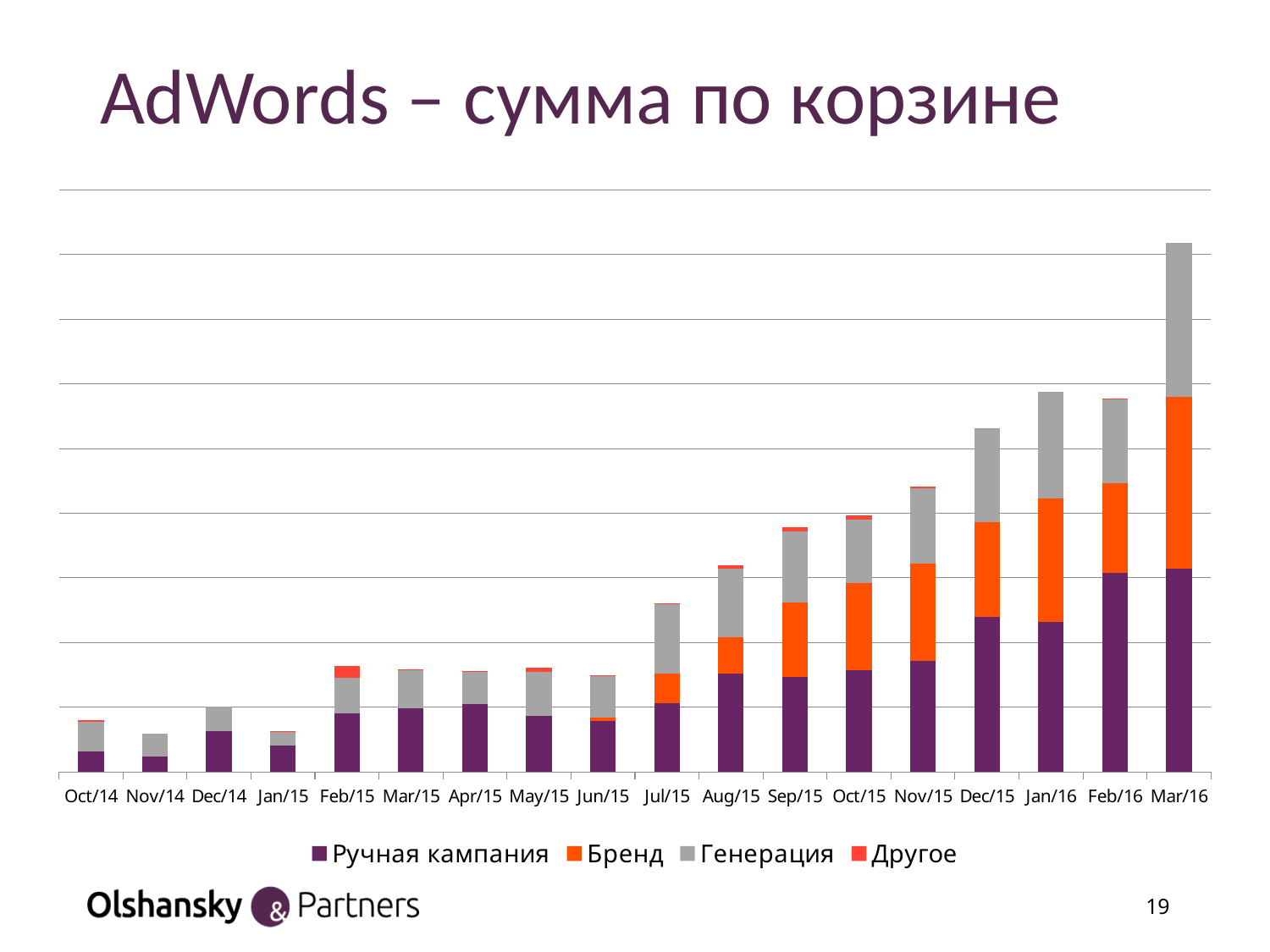
Which month has the larger total bar, Feb/16 or Mar/16? Mar/16 Do the total bar heights generally rise or fall from Oct/14 to Mar/16? Rise Which month has the larger total bar, Nov/14 or Dec/14? Dec/14 How many series does the legend of the chart list? 4 What is the title of the chart on the slide? AdWords – сумма по корзине Which month has the lowest total bar in the chart? Nov/14 Which series is shown in orange in the chart's legend? Бренд Which month has the highest total bar in the chart? Mar/16 What kind of chart is shown on the slide? Stacked bar chart Which month has the larger total bar, Jul/15 or Dec/15? Dec/15 How many months (categories) are shown on the x axis of the chart? 18